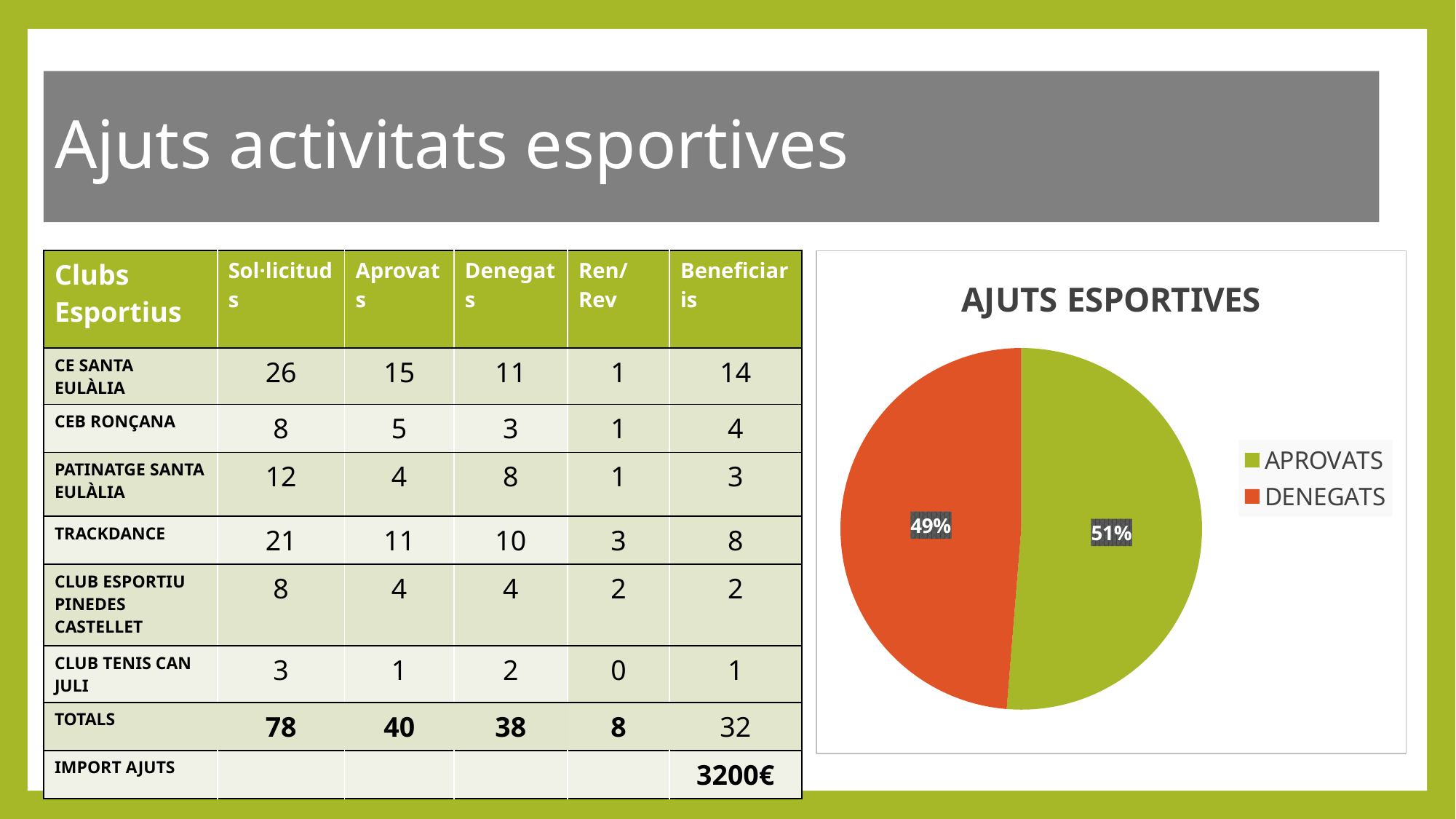
What is the difference in percentage points between the APROVATS and DENEGATS slices? 2 percentage points What colour is the DENEGATS slice in the pie chart? orange Which is larger in the pie chart, APROVATS or DENEGATS? APROVATS Which slice of the pie chart is the smallest? DENEGATS How many entries does the chart legend list? 2 What kind of chart is shown on the slide? pie chart What share of the pie does APROVATS represent? 51% What share of the pie does DENEGATS represent? 49% What is the title of the chart? AJUTS ESPORTIVES How many slices does the pie chart have? 2 Which slice of the pie chart is the largest? APROVATS